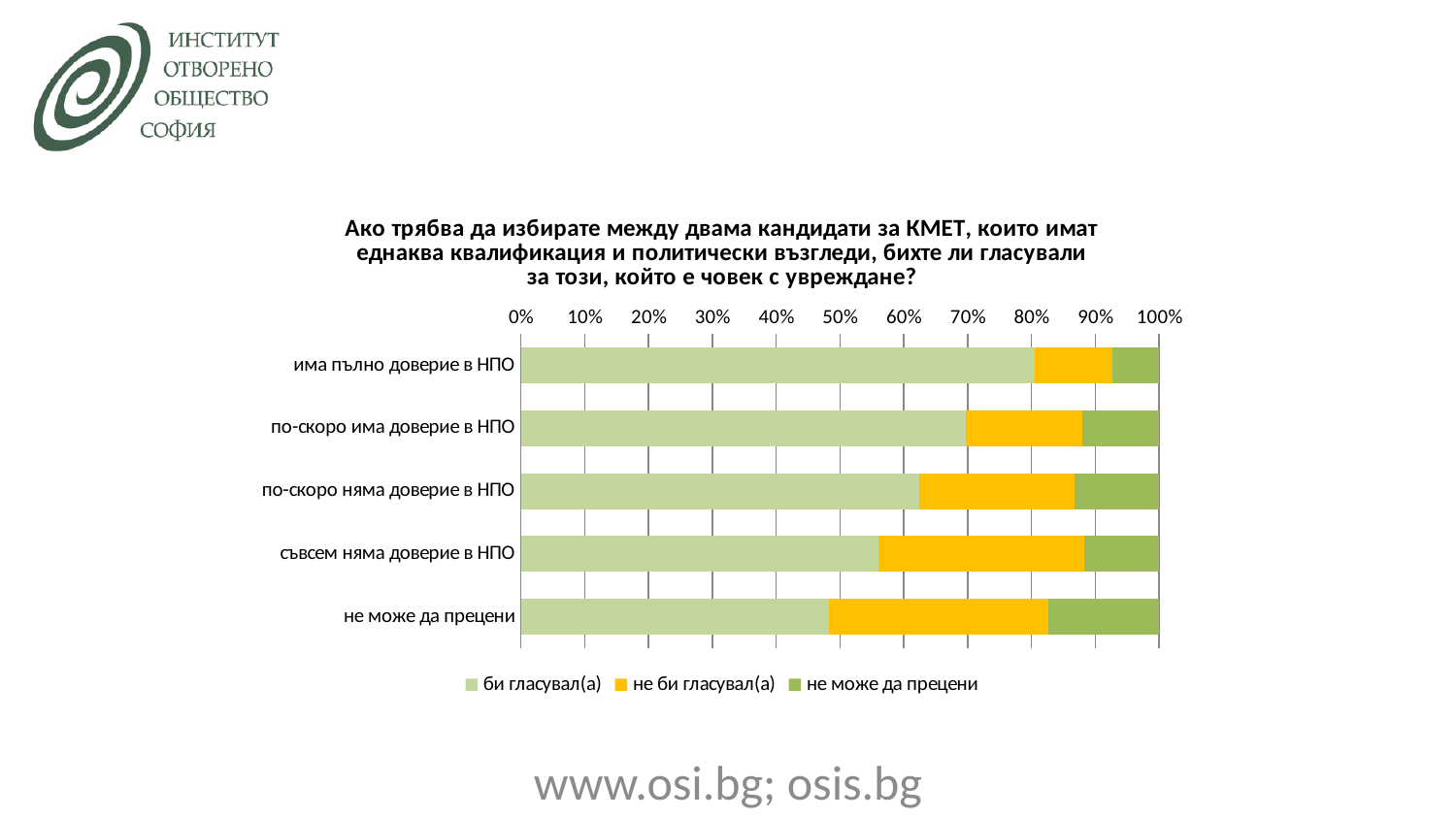
What is the first legend entry of the chart? би гласувал(а) Is the 'би гласувал(а)' share for 'не може да прецени' greater or less than 60%? less Which category has the larger 'не би гласувал(а)' share: 'съвсем няма доверие в НПО' or 'има пълно доверие в НПО'? съвсем няма доверие в НПО Does the 'би гласувал(а)' share rise or fall going down the categories from 'има пълно доверие в НПО' to 'не може да прецени'? fall How many categories (rows) are shown on the chart? 5 Which series is shown in the yellow/orange colour in the legend? не би гласувал(а) Which category has the largest share for 'би гласувал(а)'? има пълно доверие в НПО Is the 'би гласувал(а)' share for 'има пълно доверие в НПО' greater or less than 70%? greater What kind of chart is shown on the slide? stacked bar chart Is the 'би гласувал(а)' share for 'по-скоро няма доверие в НПО' greater or less than 50%? greater How many series does the legend list? 3 Which category has the smallest share for 'би гласувал(а)'? не може да прецени